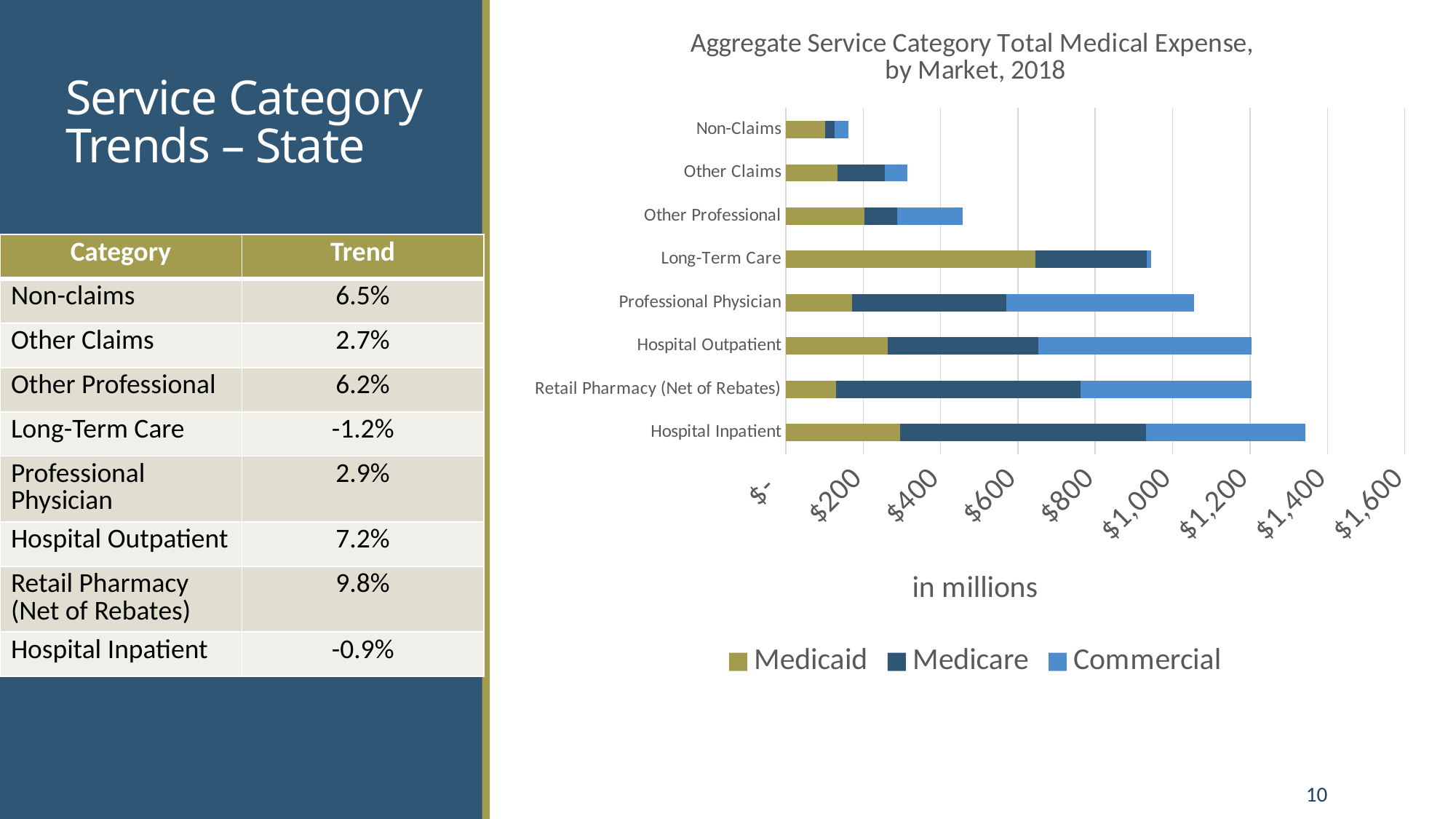
What is the title of the chart? Aggregate Service Category Total Medical Expense, by Market, 2018 Is the total bar for Hospital Inpatient greater or less than $1,200? greater Is the total bar for Long-Term Care greater or less than $800? greater Is the total bar for Other Professional greater or less than $600? less How many series does the chart legend list? 3 Which service category has the smallest total medical expense in the chart? Non-Claims What kind of chart is shown on the slide? Stacked bar chart How many service categories are plotted in the chart? 8 Which has the larger total medical expense, Long-Term Care or Other Professional? Long-Term Care Which service category has the largest total medical expense in the chart? Hospital Inpatient Which category has the larger Medicaid segment, Long-Term Care or Hospital Inpatient? Long-Term Care